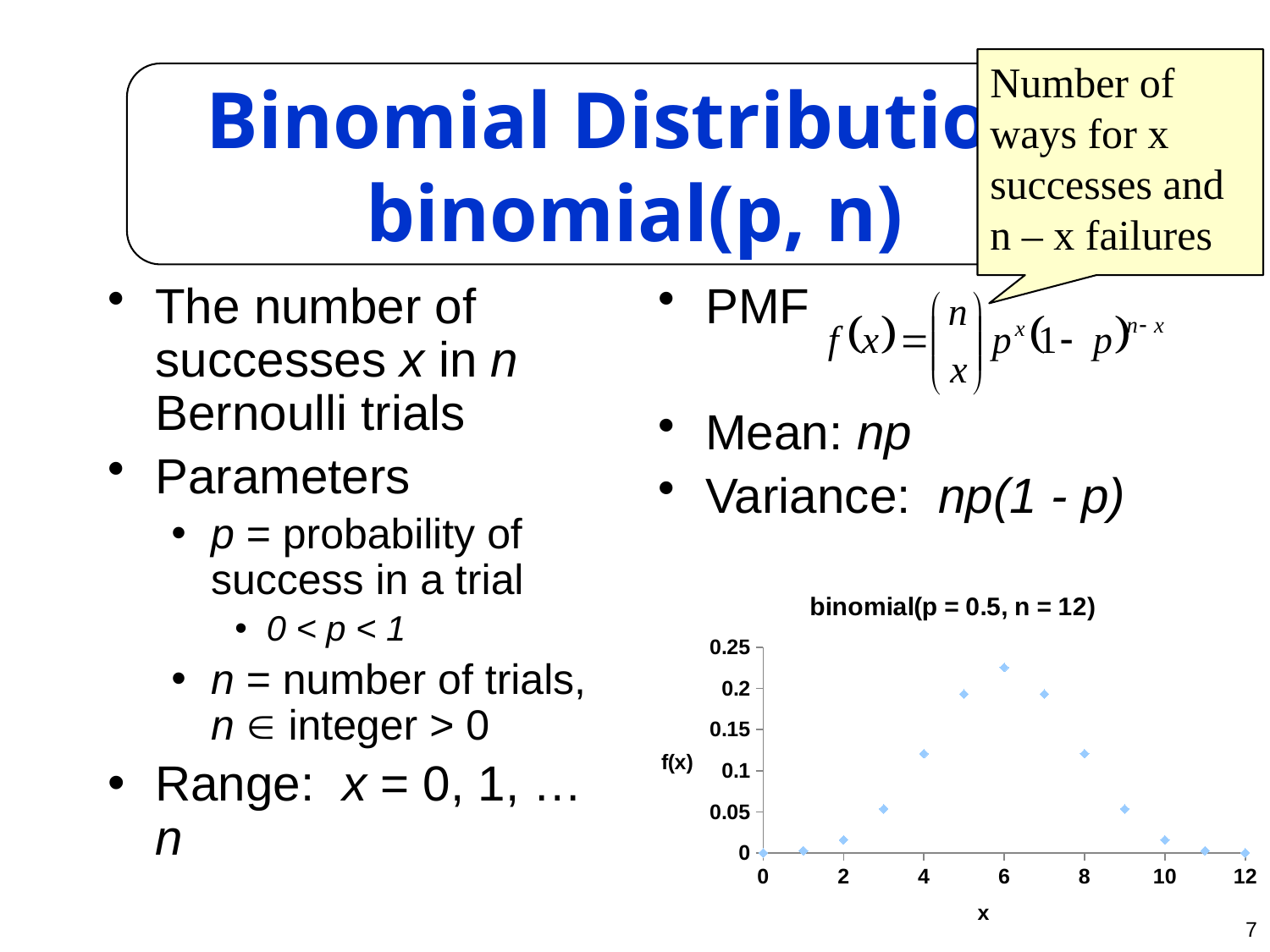
At which value of x does f(x) reach its highest point in the chart? 6 Is the value of f(x) at x = 2 greater or less than 0.05? less Is the value of f(x) at x = 6 greater or less than 0.2? greater What is the title of the chart on the slide? binomial(p = 0.5, n = 12) How does f(x) change as x increases from 0 to 12 in the chart? rises to a peak at x = 6, then falls What is the label of the vertical axis of the chart? f(x) Which has the larger f(x) value in the chart, x = 4 or x = 6? x = 6 Is the value of f(x) at x = 5 greater or less than 0.15? greater What kind of chart is shown on the slide? scatter chart How many data points are plotted in the chart? 13